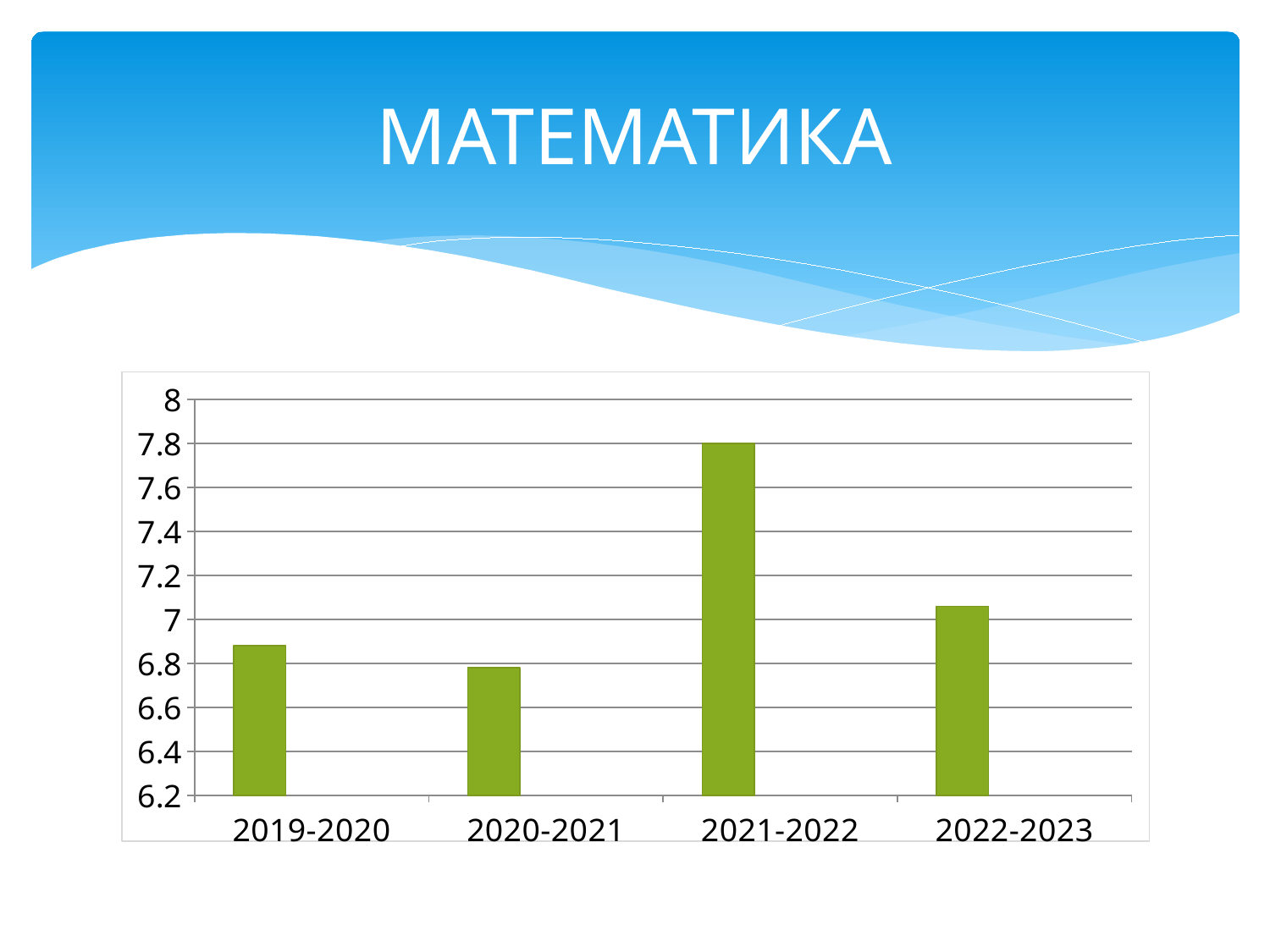
Which is larger, the value for 2022-2023 or the value for 2019-2020? 2022-2023 Is the value for 2019-2020 greater or less than 7? less Is the value for 2022-2023 greater or less than 7? greater Is the value for 2020-2021 greater or less than 7? less What is the value for 2021-2022 in the chart? 7.8 How many categories (school years) are shown on the x axis of the chart? 4 Does the value rise or fall from 2021-2022 to 2022-2023? fall What kind of chart is shown on the slide? bar chart What is the title shown above the chart on the slide? МАТЕМАТИКА Which school year has the lowest bar in the chart? 2020-2021 Which school year has the highest bar in the chart? 2021-2022